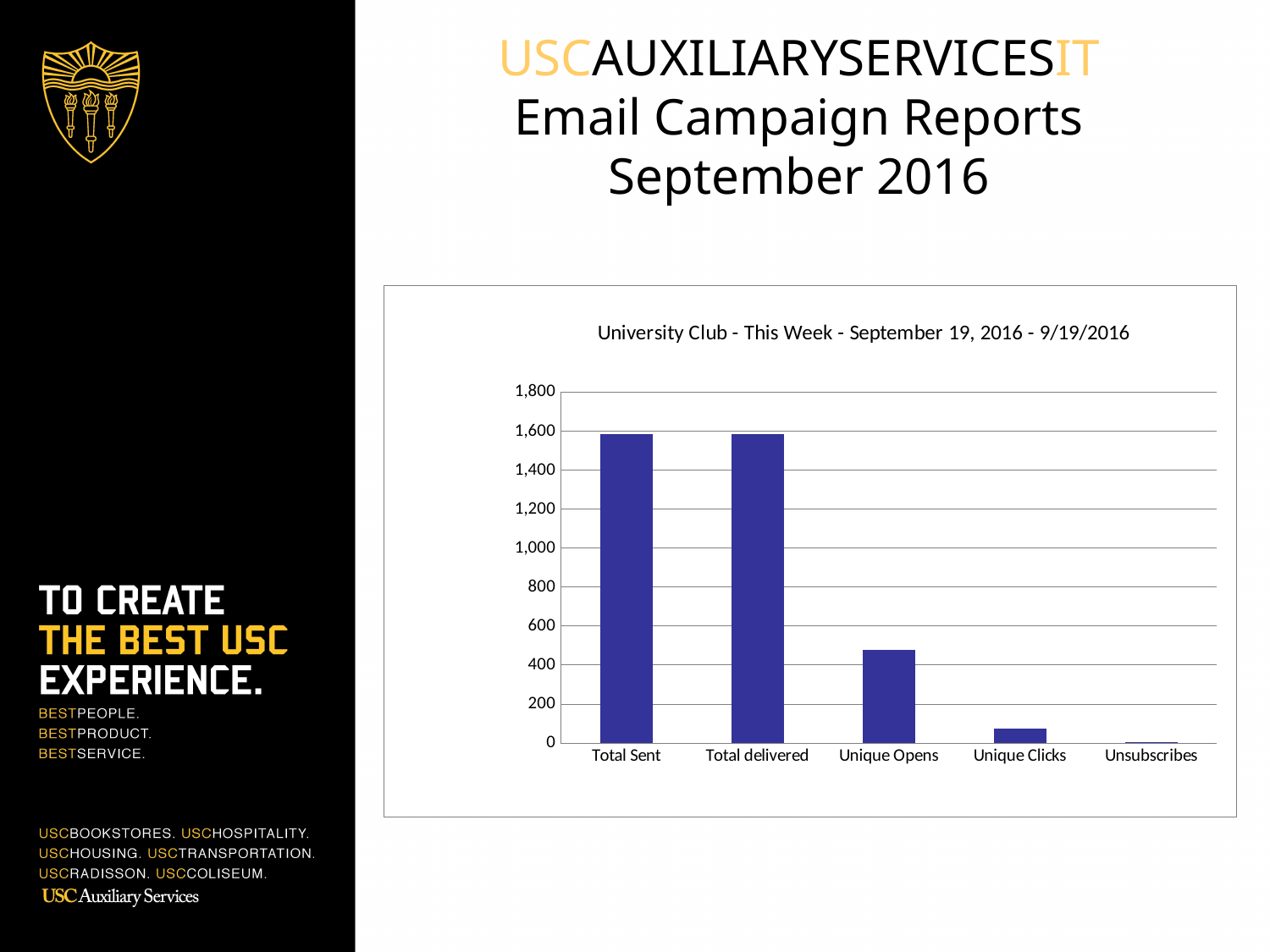
Is the value for Unique Opens greater or less than 600? less Is the value for Unique Clicks greater or less than 200? less What is the title of the chart? University Club - This Week - September 19, 2016 - 9/19/2016 Is the value for Total Sent greater or less than 1,400? greater Which is larger, the value for Total delivered or the value for Unique Opens? Total delivered Do the values generally rise or fall moving from left to right along the x axis? fall Which is larger, the value for Unique Opens or the value for Unique Clicks? Unique Opens How many categories are shown on the x axis of the chart? 5 Which category has the lowest value in the chart? Unsubscribes What kind of chart is shown on the slide? bar chart